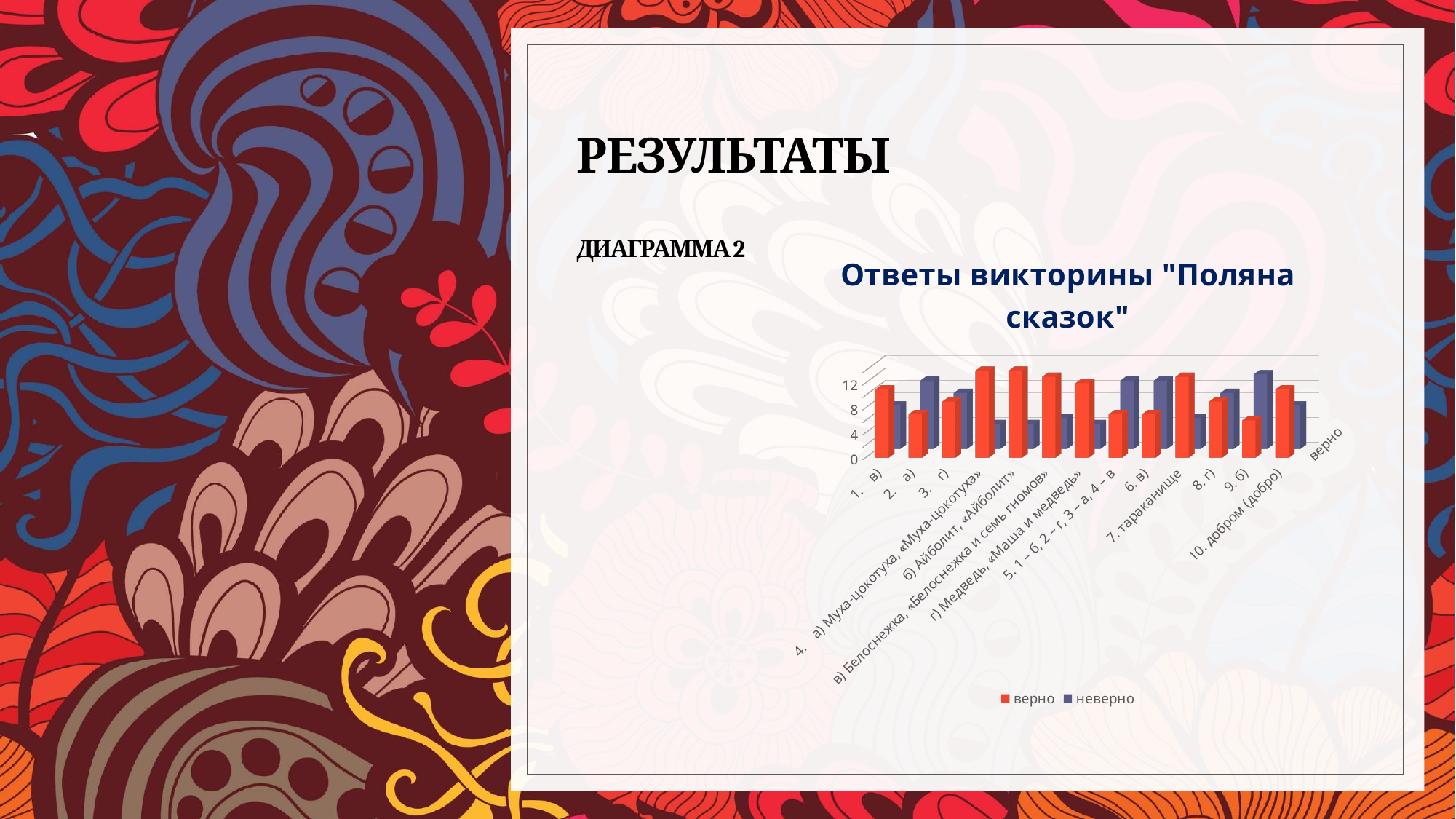
Is the value of верно for 1. в) greater or less than 8? greater How many series does the legend of the chart list? 2 What kind of chart is shown on the slide? bar chart For 9. б), which series has the larger value, верно or неверно? неверно Which series is shown in red in the chart? верно What is the title of the chart? Ответы викторины "Поляна сказок" For 4. а) Муха-цокотуха, «Муха-цокотуха», which series has the larger value, верно or неверно? верно Is the value of верно for 4. а) Муха-цокотуха, «Муха-цокотуха» greater or less than 12? greater Is the value of верно for 9. б) greater or less than 8? less For 1. в), which series has the larger value, верно or неверно? верно